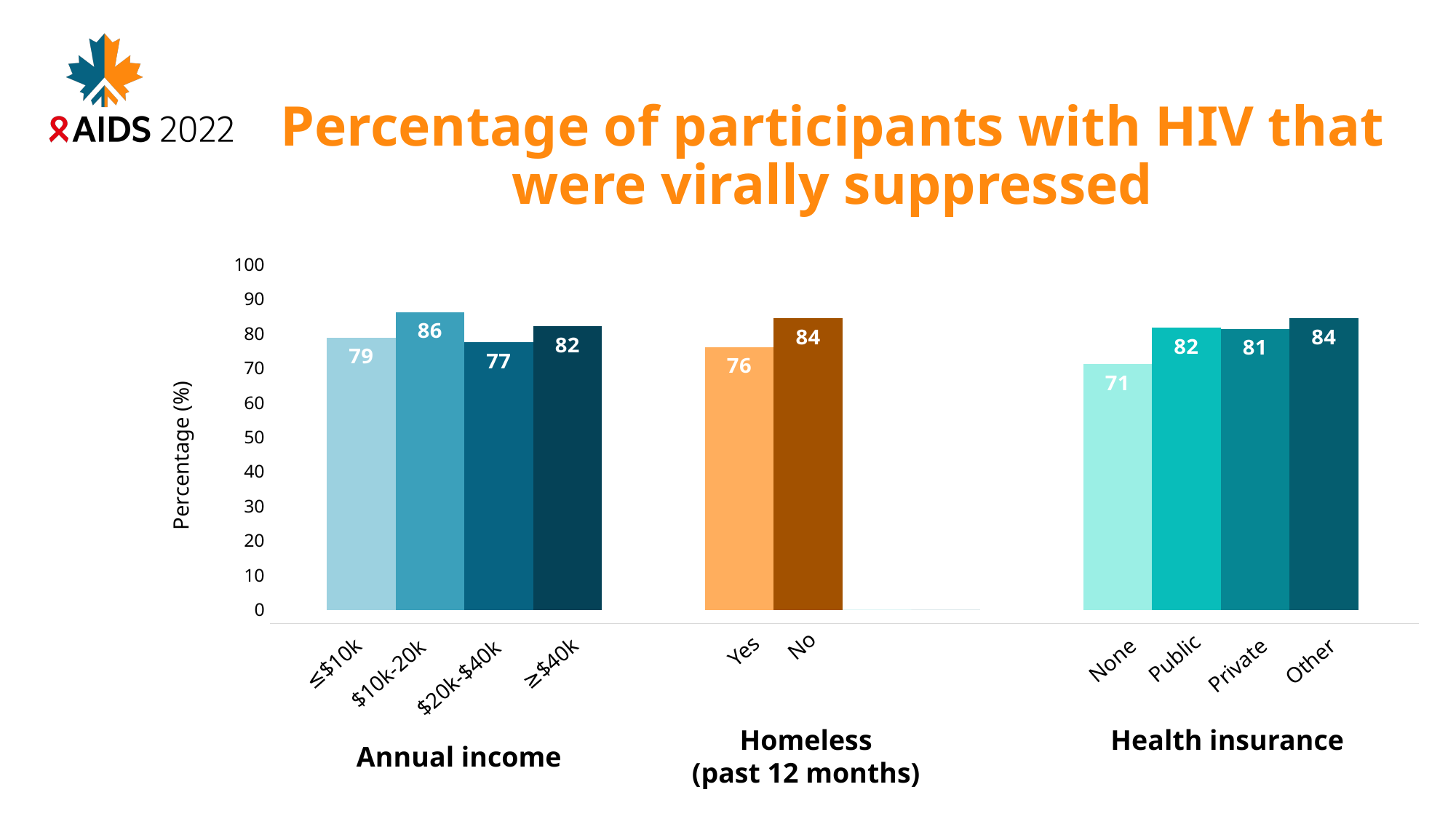
What is the label of the vertical axis? Percentage (%) How many bars are shown in the Annual income group? 4 Which is larger: the value for Public health insurance or for Private health insurance? Public What kind of chart is shown on the slide? Bar chart What is the value for participants who were homeless in the past 12 months (Yes)? 76 Which health insurance category has the lowest percentage virally suppressed? None Which annual income group has the highest percentage virally suppressed? $10k-20k What is the difference between the No and Yes values in the Homeless (past 12 months) group? 8 What is the value for participants with no health insurance (None)? 71 What is the difference between the $10k-20k and $20k-$40k income groups? 9 How many bars are plotted on the chart in total? 10 What percentage of participants with annual income ≤$10k were virally suppressed? 79